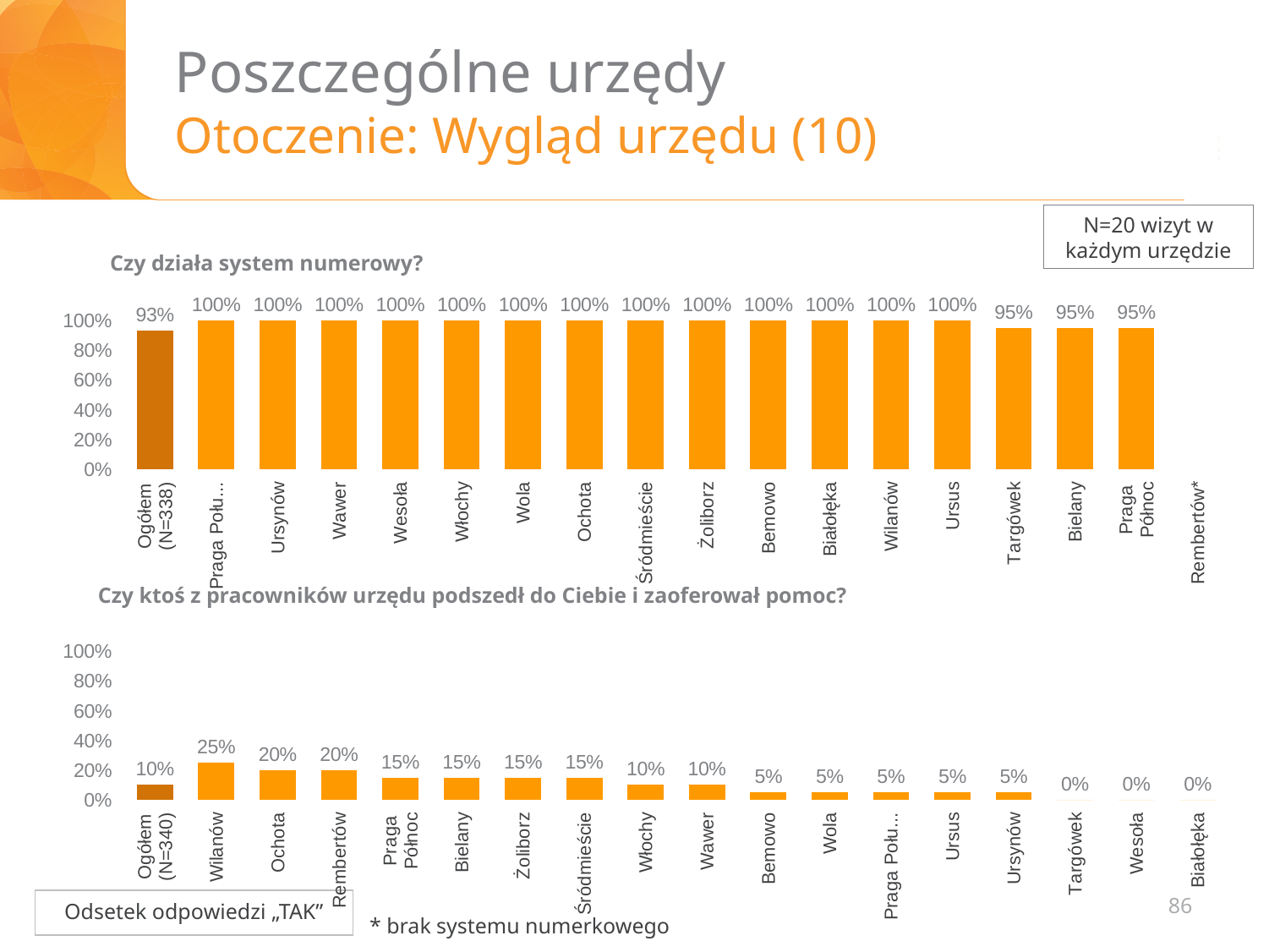
In the top chart 'Czy działa system numerowy?', what is the difference between Ursynów and Bielany? 5% In the top chart 'Czy działa system numerowy?', what is the value for Wilanów? 100% In the top chart 'Czy działa system numerowy?', what is the value for Targówek? 95% In the bottom chart 'Czy ktoś z pracowników urzędu podszedł do Ciebie i zaoferował pomoc?', which is larger, Rembertów or Ursus? Rembertów In the bottom chart 'Czy ktoś z pracowników urzędu podszedł do Ciebie i zaoferował pomoc?', how many categories are shown on the x axis? 18 What type of chart is the top chart 'Czy działa system numerowy?'? Bar chart In the bottom chart 'Czy ktoś z pracowników urzędu podszedł do Ciebie i zaoferował pomoc?', what is the difference between Wilanów and Bielany? 10% In the bottom chart 'Czy ktoś z pracowników urzędu podszedł do Ciebie i zaoferował pomoc?', do the values rise or fall from Wilanów to Białołęka along the x axis? Fall In the bottom chart 'Czy ktoś z pracowników urzędu podszedł do Ciebie i zaoferował pomoc?', which category has the highest value? Wilanów In the bottom chart 'Czy ktoś z pracowników urzędu podszedł do Ciebie i zaoferował pomoc?', what is the value for Ochota? 20% In the bottom chart 'Czy ktoś z pracowników urzędu podszedł do Ciebie i zaoferował pomoc?', what is the value for Ogółem (N=340)? 10% In the top chart 'Czy działa system numerowy?', what is the value for Ogółem (N=338)? 93%